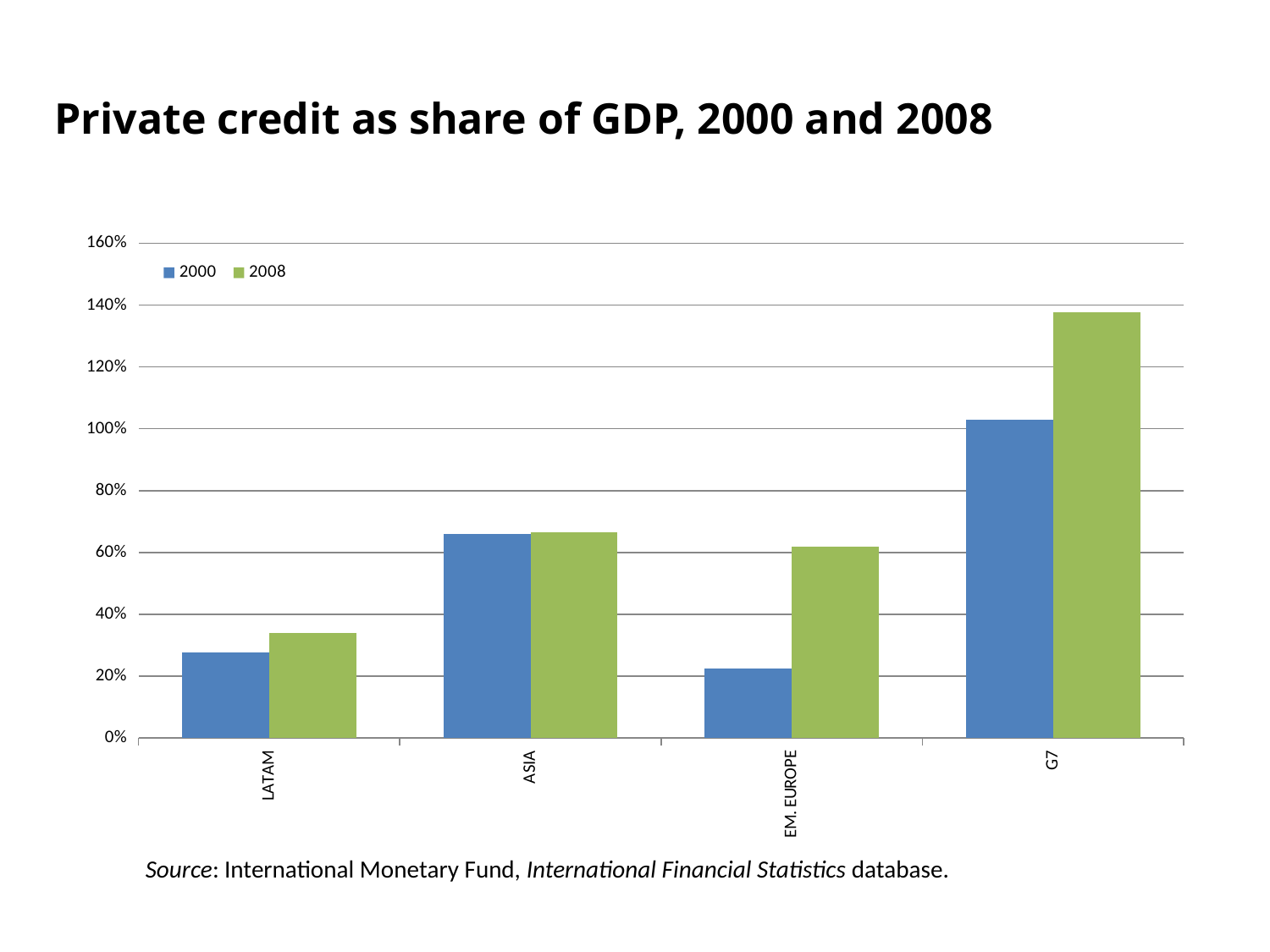
How many series does the legend list? 2 Which is larger for 2008: EM. EUROPE or LATAM? EM. EUROPE How many regions are shown on the x axis? 4 Is the value for G7 in 2000 greater or less than 80%? greater Which is larger for G7: the 2000 value or the 2008 value? 2008 Is the value for LATAM in 2008 greater or less than 40%? less What is the title of the chart? Private credit as share of GDP, 2000 and 2008 What kind of chart is shown on the slide? bar chart Which region has the highest value for 2008? G7 Is the value for G7 in 2008 greater or less than 120%? greater Which region has the lowest value for 2000? EM. EUROPE